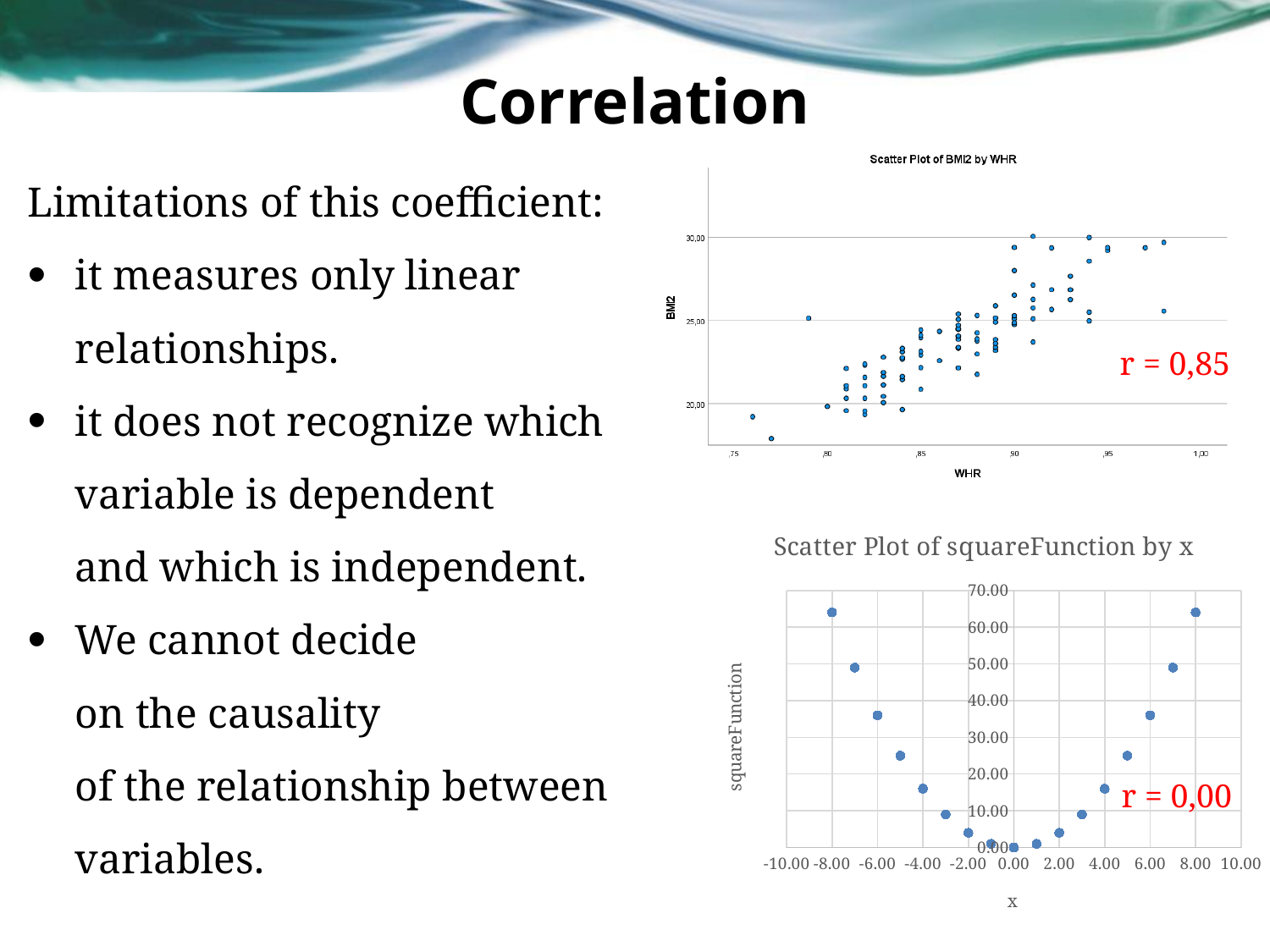
In the top chart, 'Scatter Plot of BMI2 by WHR', is the highest BMI2 value greater or less than 25,00? greater What kind of chart is the top chart on the slide? scatter plot What correlation coefficient r is printed on the top chart, 'Scatter Plot of BMI2 by WHR'? r = 0,85 In the bottom chart, 'Scatter Plot of squareFunction by x', is the value at x = -8.00 greater or less than 60.00? greater In the bottom chart, 'Scatter Plot of squareFunction by x', do the values rise or fall as x goes from -8.00 to 0.00? fall What is the title of the top chart? Scatter Plot of BMI2 by WHR What is the y-axis label of the bottom chart, 'Scatter Plot of squareFunction by x'? squareFunction How many data points are plotted in the bottom chart, 'Scatter Plot of squareFunction by x'? 17 What kind of chart is the bottom chart, 'Scatter Plot of squareFunction by x'? scatter plot In the bottom chart, 'Scatter Plot of squareFunction by x', is the value at x = 2.00 greater or less than 10.00? less In the bottom chart, 'Scatter Plot of squareFunction by x', which is larger: the value at x = -8.00 or the value at x = -4.00? x = -8.00 What correlation coefficient r is printed on the bottom chart, 'Scatter Plot of squareFunction by x'? r = 0,00